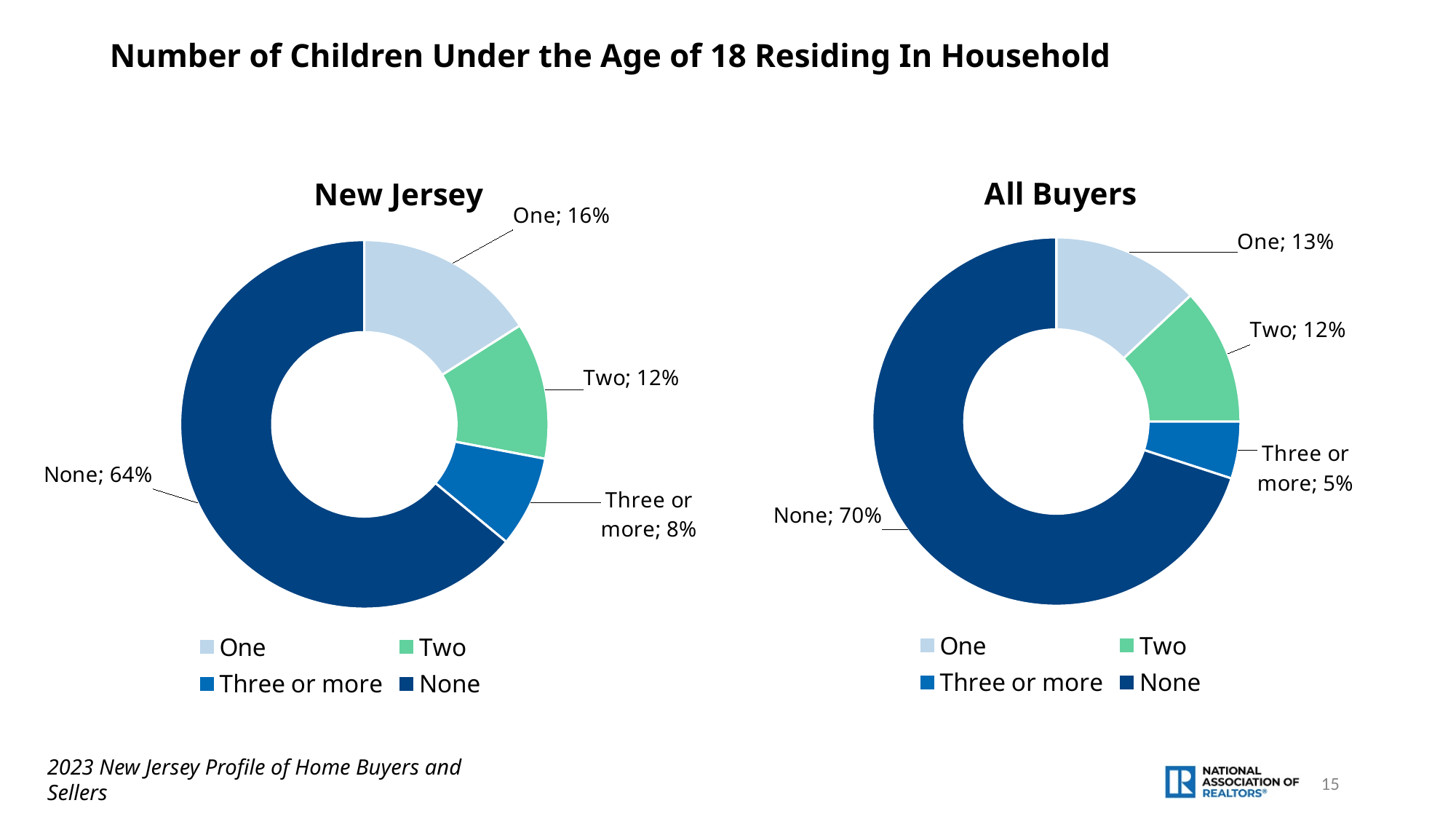
In the All Buyers chart, what percentage of households have one child under 18? 13% How many categories does the New Jersey chart show? 4 In the New Jersey chart, which category has the smallest share? Three or more What is the title of the slide? Number of Children Under the Age of 18 Residing In Household What type of chart is used for the All Buyers data? Doughnut (pie) chart In the New Jersey chart, what is the difference between the One share and the Two share? 4 percentage points In the All Buyers chart, what percentage of households have three or more children? 5% In the New Jersey chart, what percentage of households have no children under 18? 64% In the All Buyers chart, which category has the smallest share? Three or more Which chart shows a larger share for Three or more children, New Jersey or All Buyers? New Jersey What is the difference between the None share in the All Buyers chart and the None share in the New Jersey chart? 6 percentage points In the New Jersey chart, which category has the largest share? None